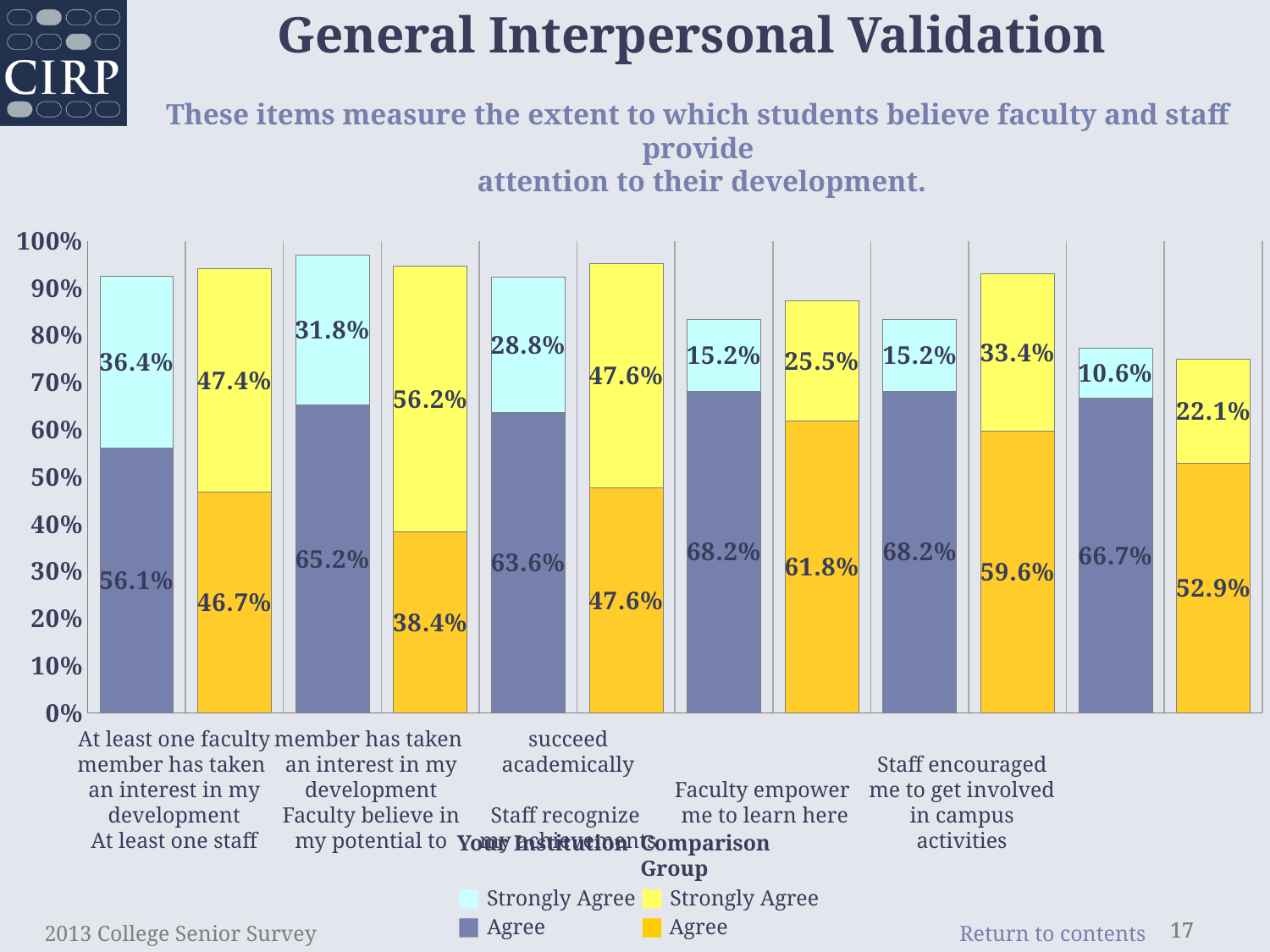
Is the total height of the Your Institution bar for 'Staff encouraged me to get involved in campus activities' greater or less than 70%? greater For 'At least one faculty member has taken an interest in my development', which has the higher Strongly Agree value: Your Institution or the Comparison Group? Comparison Group What is the combined Agree plus Strongly Agree total for the Comparison Group on 'Staff encouraged me to get involved in campus activities'? 75.0% For 'Faculty empower me to learn here', how much higher is the Your Institution Agree value than the Comparison Group Agree value? 8.6 percentage points What is the combined Agree plus Strongly Agree total for Your Institution on 'At least one faculty member has taken an interest in my development'? 92.5% Which item has the highest Comparison Group Strongly Agree value? At least one staff member has taken an interest in my development Which item has the lowest Your Institution Strongly Agree value? Staff encouraged me to get involved in campus activities What is the Comparison Group Agree value for 'Faculty believe in my potential to succeed academically'? 47.6% What percentage of Your Institution students Agree that 'Faculty empower me to learn here'? 68.2% How many series does the legend list? 4 What is the Comparison Group Strongly Agree value for 'Staff encouraged me to get involved in campus activities'? 22.1% What type of chart is shown on the slide? Stacked bar chart